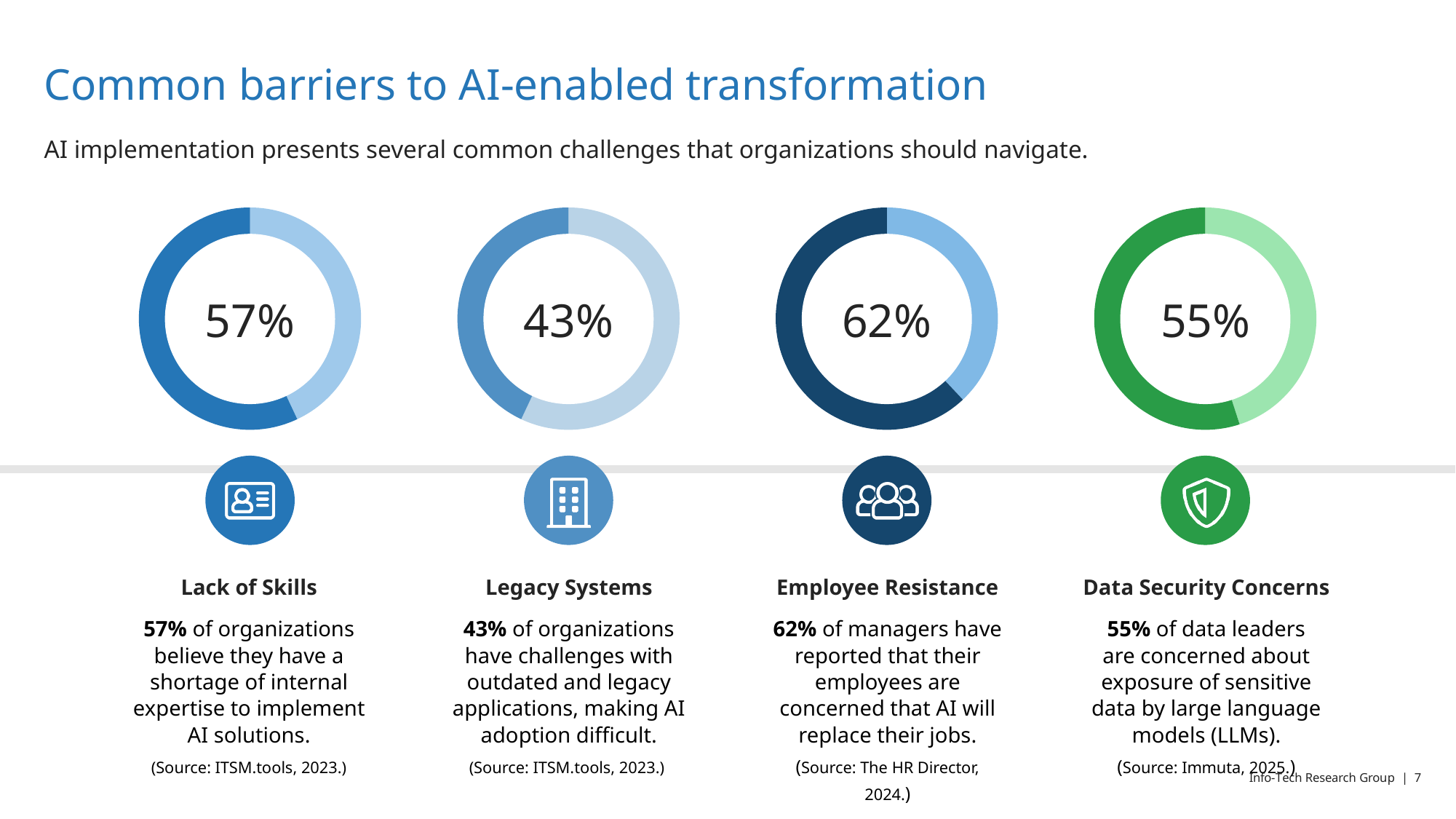
Which of the four barriers has the lowest percentage? Legacy Systems What percentage is shown in the Legacy Systems donut chart? 43% What percentage is shown in the Data Security Concerns donut chart? 55% What percentage is shown in the Employee Resistance donut chart? 62% What is the difference between the Lack of Skills percentage and the Data Security Concerns percentage? 2% Which is larger, the Lack of Skills percentage or the Legacy Systems percentage? Lack of Skills What is the difference between the Employee Resistance percentage and the Legacy Systems percentage? 19% What colour is the Data Security Concerns donut chart? Green What percentage is shown in the Lack of Skills donut chart? 57% How many donut charts are shown on the slide? 4 What kind of chart is used to display each percentage on the slide? Donut chart Which of the four barriers has the highest percentage? Employee Resistance